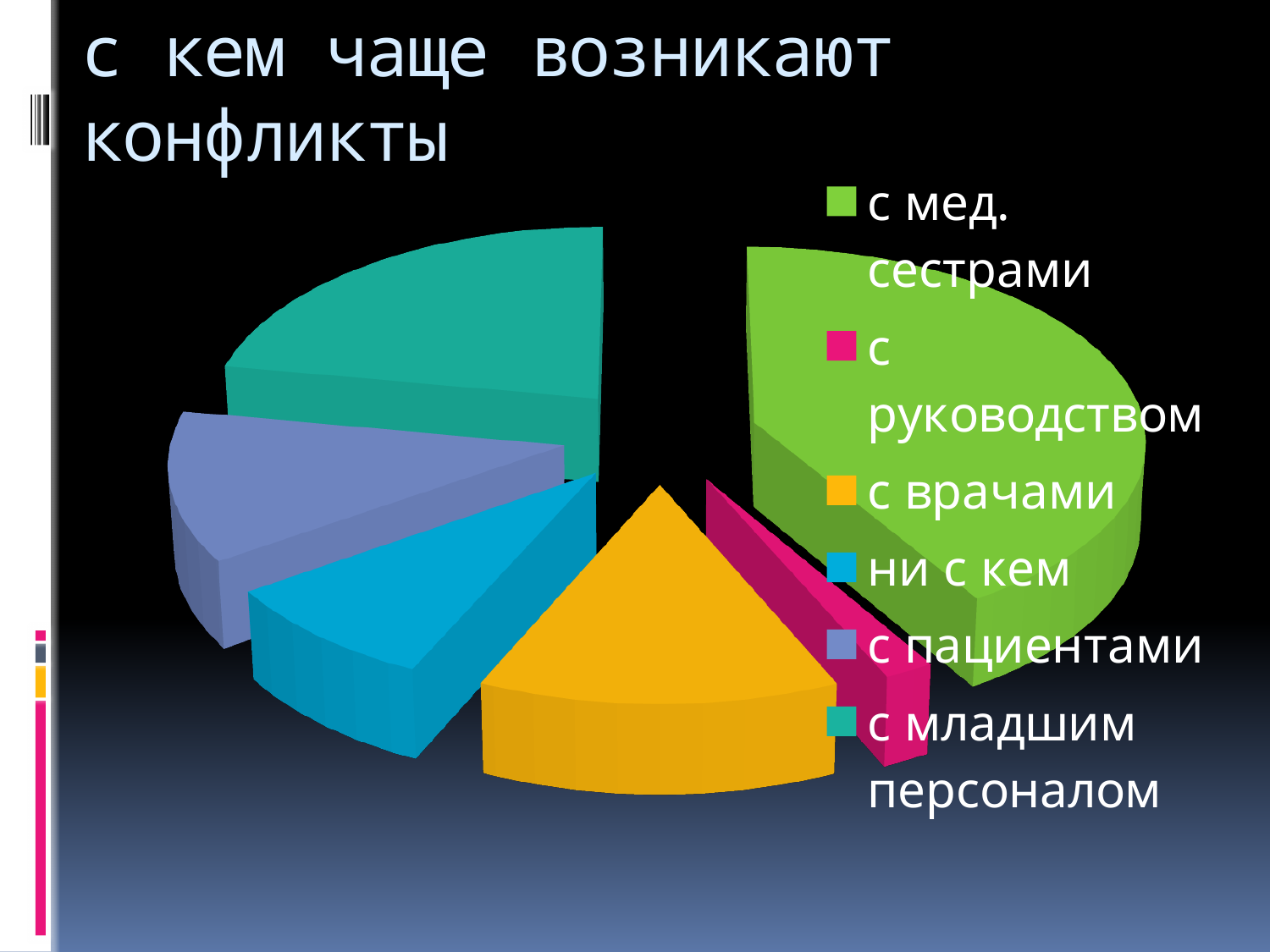
What is the title of the chart on the slide? с кем чаще возникают конфликты Which slice is larger: 'с мед. сестрами' or 'с руководством'? с мед. сестрами How many categories (slices) does the pie chart have? 6 Which category has the largest slice of the pie chart? с мед. сестрами Which category has the smallest slice of the pie chart? с руководством Which slice is larger: 'с мед. сестрами' or 'ни с кем'? с мед. сестрами Which slice is larger: 'с врачами' or 'с руководством'? с врачами Which colour represents the category 'с мед. сестрами' in the pie chart? green What kind of chart is shown on the slide? pie chart How many entries does the legend of the pie chart list? 6